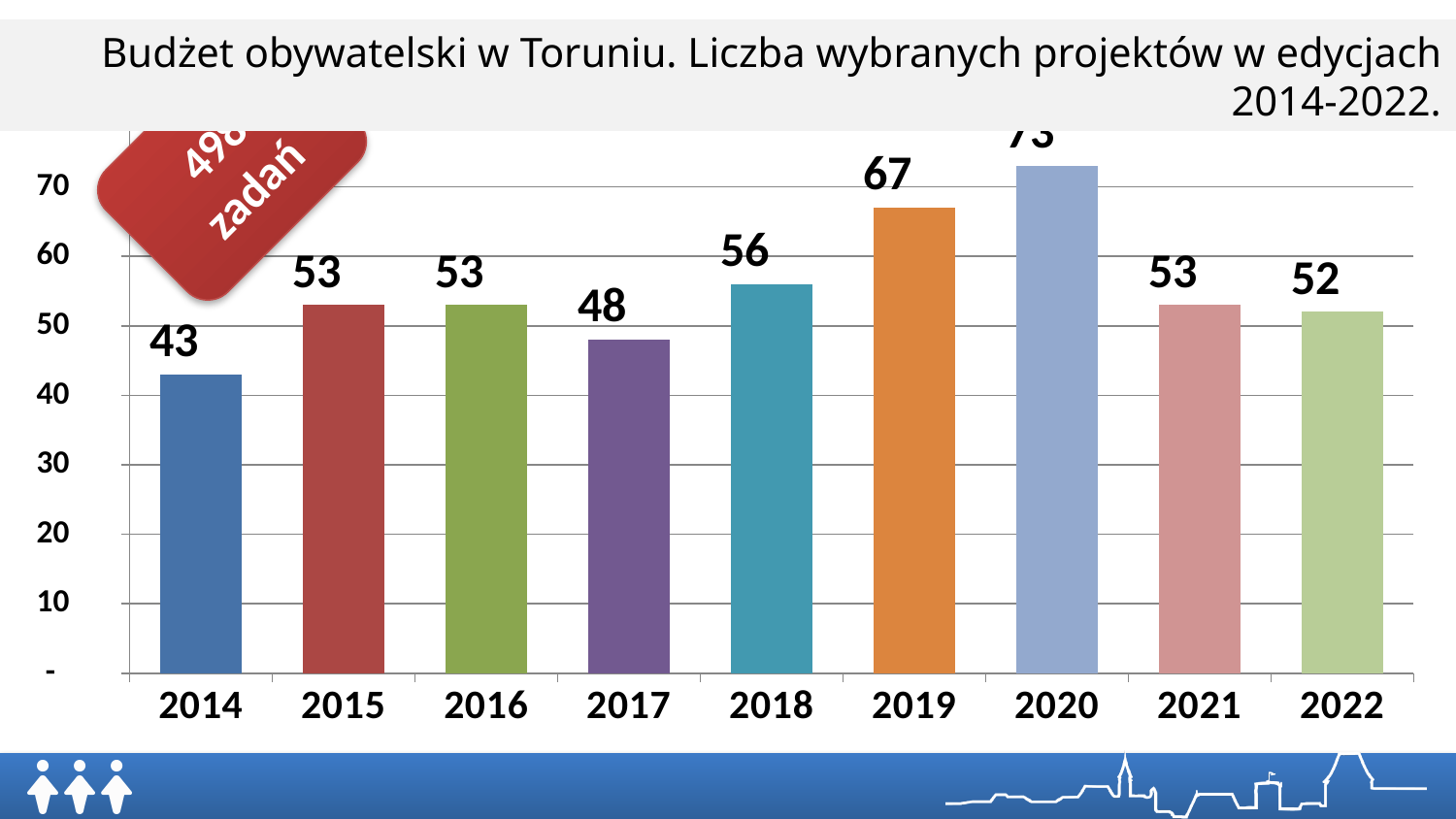
Which year has the lowest value? 2014 Which year has the highest bar? 2020 How many selected projects were there in 2014? 43 What is the value shown for 2022? 52 What is the value shown for 2017? 48 How many years are shown on the x axis? 9 Which is larger, the value for 2018 or the value for 2017? 2018 What is the difference between the values for 2019 and 2014? 24 What is the difference between the values for 2018 and 2017? 8 What is the value shown for 2019? 67 Is the value for 2020 greater or less than 70? greater What kind of chart is shown on the slide? bar chart